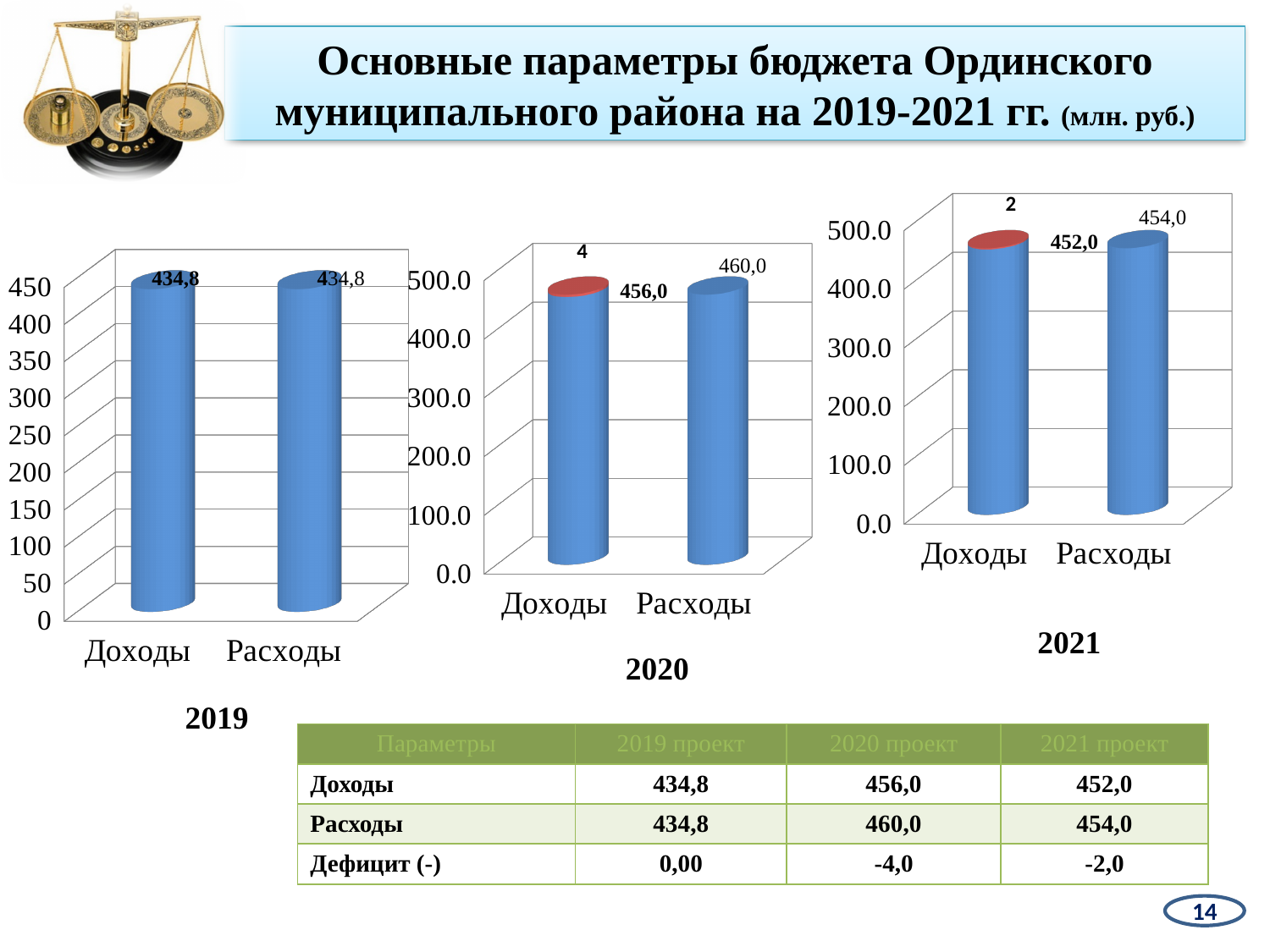
In the 2019 chart (left), what is the value for Доходы? 434,8 In the 2020 chart (middle), what is the value for Расходы? 460,0 In the 2020 chart (middle), what is the difference between Расходы and Доходы? 4,0 In the 2019 chart (left), what is the value for Расходы? 434,8 In the 2021 chart (right), what is the value for Расходы? 454,0 In the 2021 chart (right), what is the difference between Расходы and Доходы? 2,0 In the 2021 chart (right), what value is printed on the red segment on top of the Доходы bar? 2 In the 2020 chart (middle), what is the value for Доходы? 456,0 In the 2020 chart (middle), what value is printed on the red segment on top of the Доходы bar? 4 How many categories are shown on the x axis of the 2019 chart (left)? 2 What kind of chart is the 2021 chart (right)? bar chart In the 2021 chart (right), what is the value for Доходы? 452,0